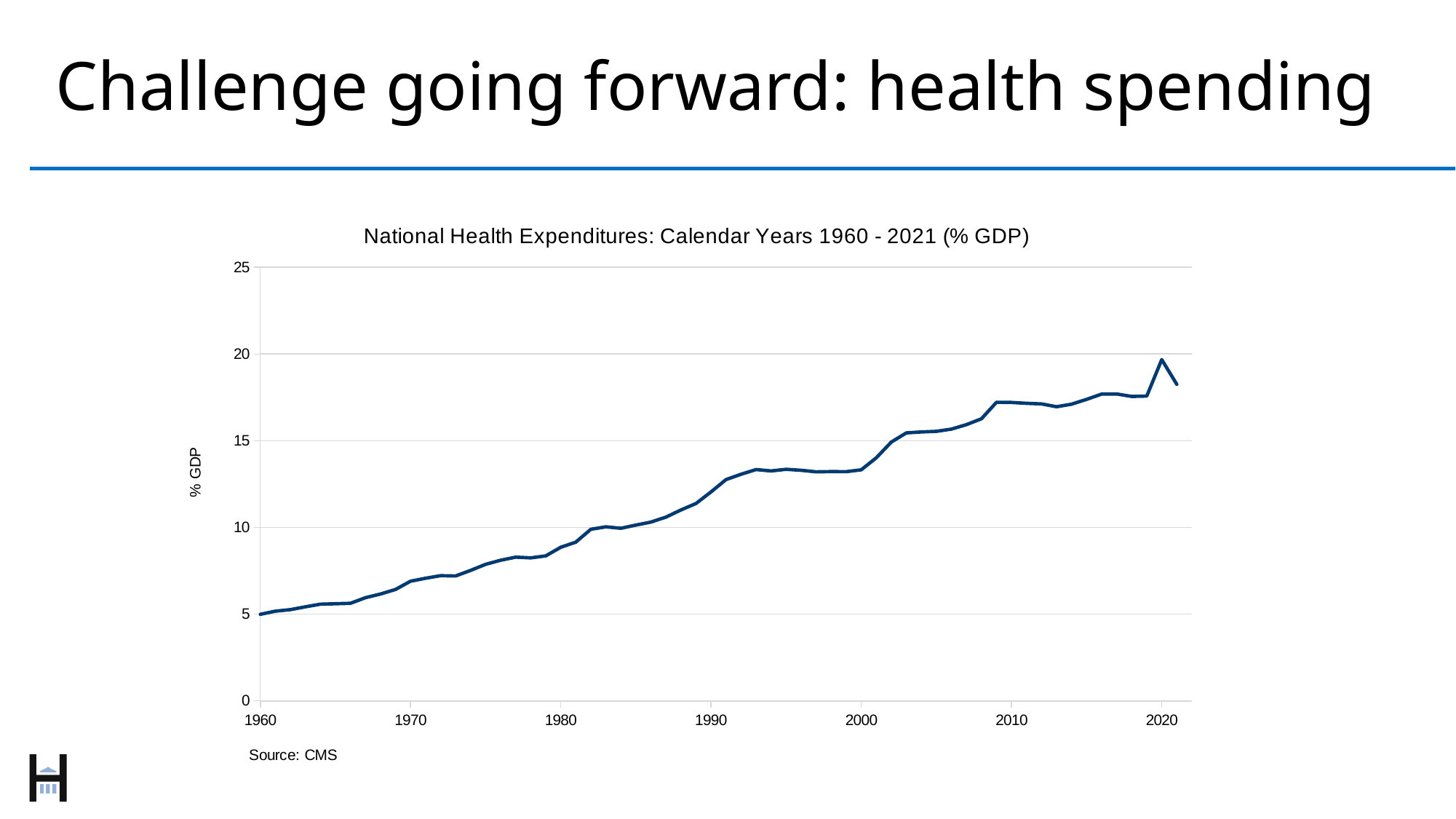
Do the values in the chart generally rise or fall from 1960 to 2021? rise What is the label on the y axis of the chart? % GDP Is the value for 1990 greater or less than 10? greater In which year does the line reach its highest value? 2020 Which year has the larger value, 1990 or 2010? 2010 Is the value for 2000 greater or less than 15? less In which year does the line have its lowest value? 1960 Is the value for 2010 greater or less than 15? greater What is the title of the chart? National Health Expenditures: Calendar Years 1960 - 2021 (% GDP) What kind of chart is shown on the slide? line chart